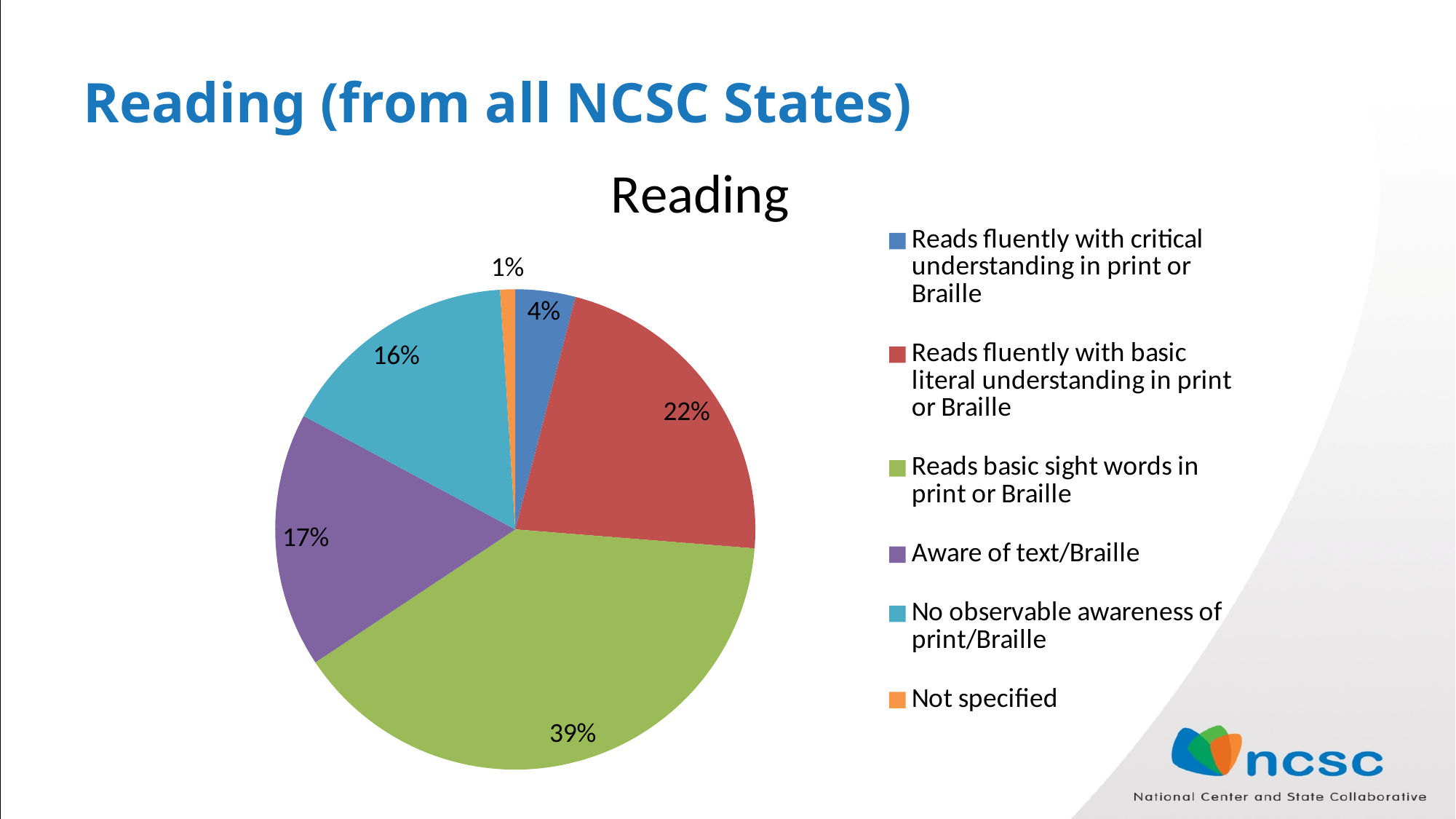
What percentage is shown for 'Reads fluently with basic literal understanding in print or Braille'? 22% What percentage is shown for 'Aware of text/Braille'? 17% What type of chart is shown on the slide? Pie chart How many categories does the legend list? 6 Which category has the smallest share of the pie? Not specified Which is larger: the share for 'Aware of text/Braille' or the share for 'Reads fluently with critical understanding in print or Braille'? Aware of text/Braille Which category has the largest share of the pie? Reads basic sight words in print or Braille What percentage is shown for 'No observable awareness of print/Braille'? 16% What percentage is shown for 'Reads fluently with critical understanding in print or Braille'? 4% What percentage of the pie is 'Reads basic sight words in print or Braille'? 39% What is the title of the chart? Reading What is the difference in percentage points between 'Reads basic sight words in print or Braille' and 'Reads fluently with basic literal understanding in print or Braille'? 17